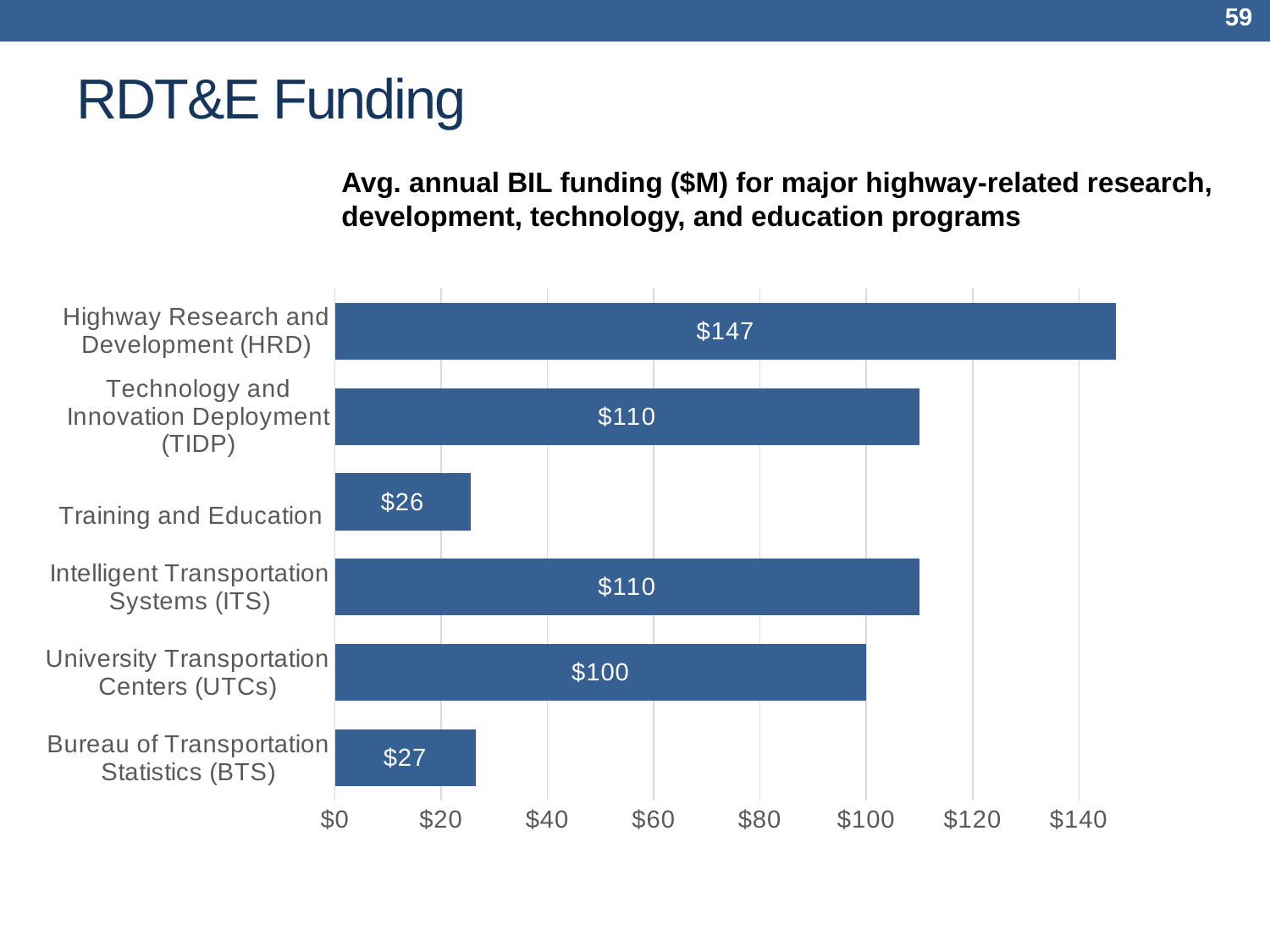
What kind of chart is shown on the slide? Bar chart Which has larger funding, Intelligent Transportation Systems (ITS) or University Transportation Centers (UTCs)? Intelligent Transportation Systems (ITS) What is the title of the chart? Avg. annual BIL funding ($M) for major highway-related research, development, technology, and education programs Which program has the lowest average annual BIL funding? Training and Education How many programs are shown in the chart? 6 Is the value for Technology and Innovation Deployment (TIDP) greater or less than $100? greater What is the average annual BIL funding for Highway Research and Development (HRD)? $147 What is the value shown for University Transportation Centers (UTCs)? $100 What is the value shown for Bureau of Transportation Statistics (BTS)? $27 What is the difference between the funding for UTCs and the funding for BTS? $73 What is the difference between the funding for HRD and the funding for TIDP? $37 Which program has the highest average annual BIL funding? Highway Research and Development (HRD)